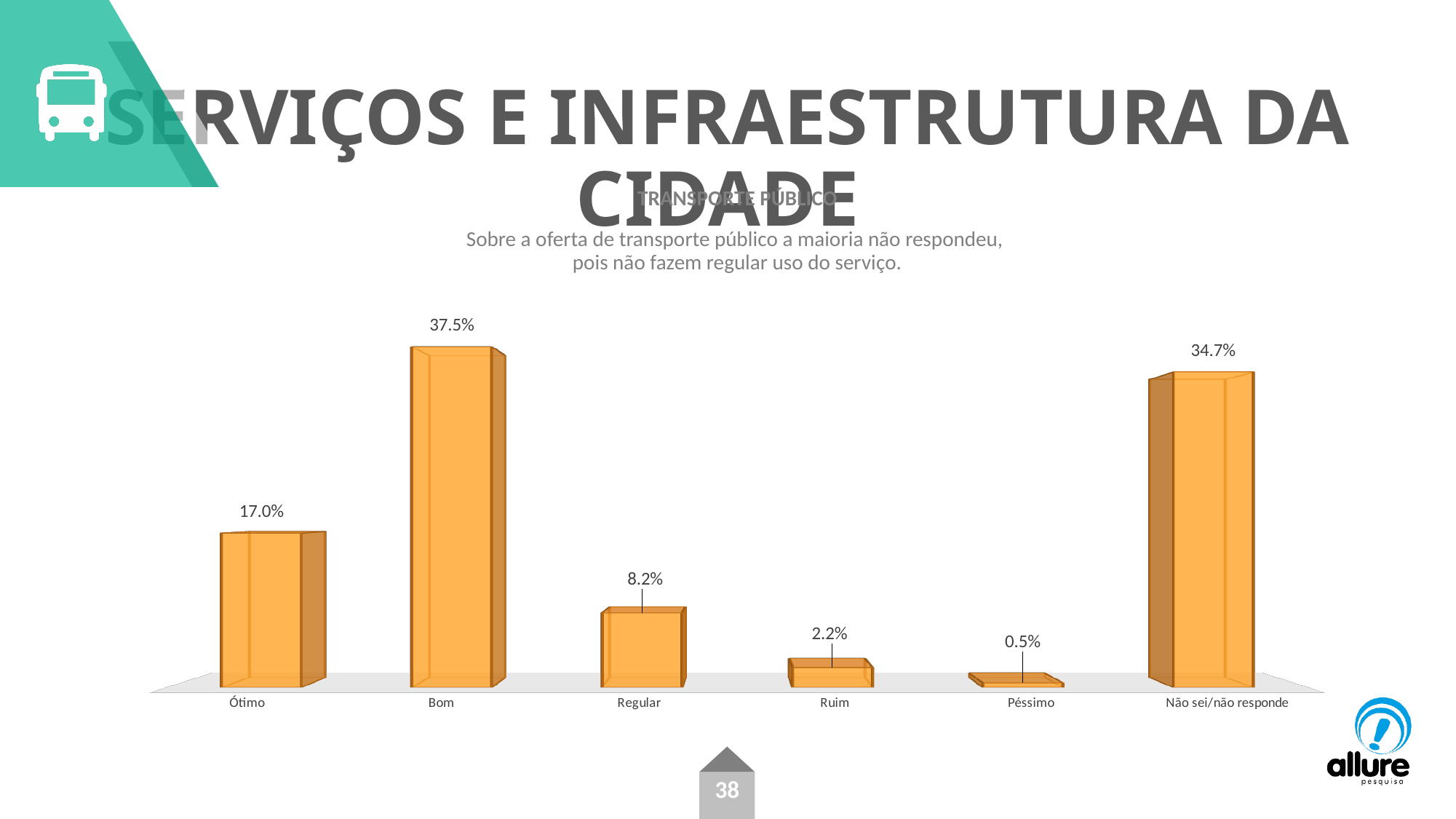
What colour are the bars in the chart? Orange What is the value for Não sei/não responde? 34.7% What is the difference between the values for Ótimo and Regular? 8.8% What is the difference between the values for Bom and Não sei/não responde? 2.8% What is the value for Péssimo? 0.5% Which category has the highest value? Bom What is the value for Ótimo? 17.0% Which category has the lowest value? Péssimo How many categories are shown on the x axis? 6 Which is larger, the value for Regular or the value for Ruim? Regular What is the value for Bom? 37.5% What kind of chart is shown on the slide? Bar chart